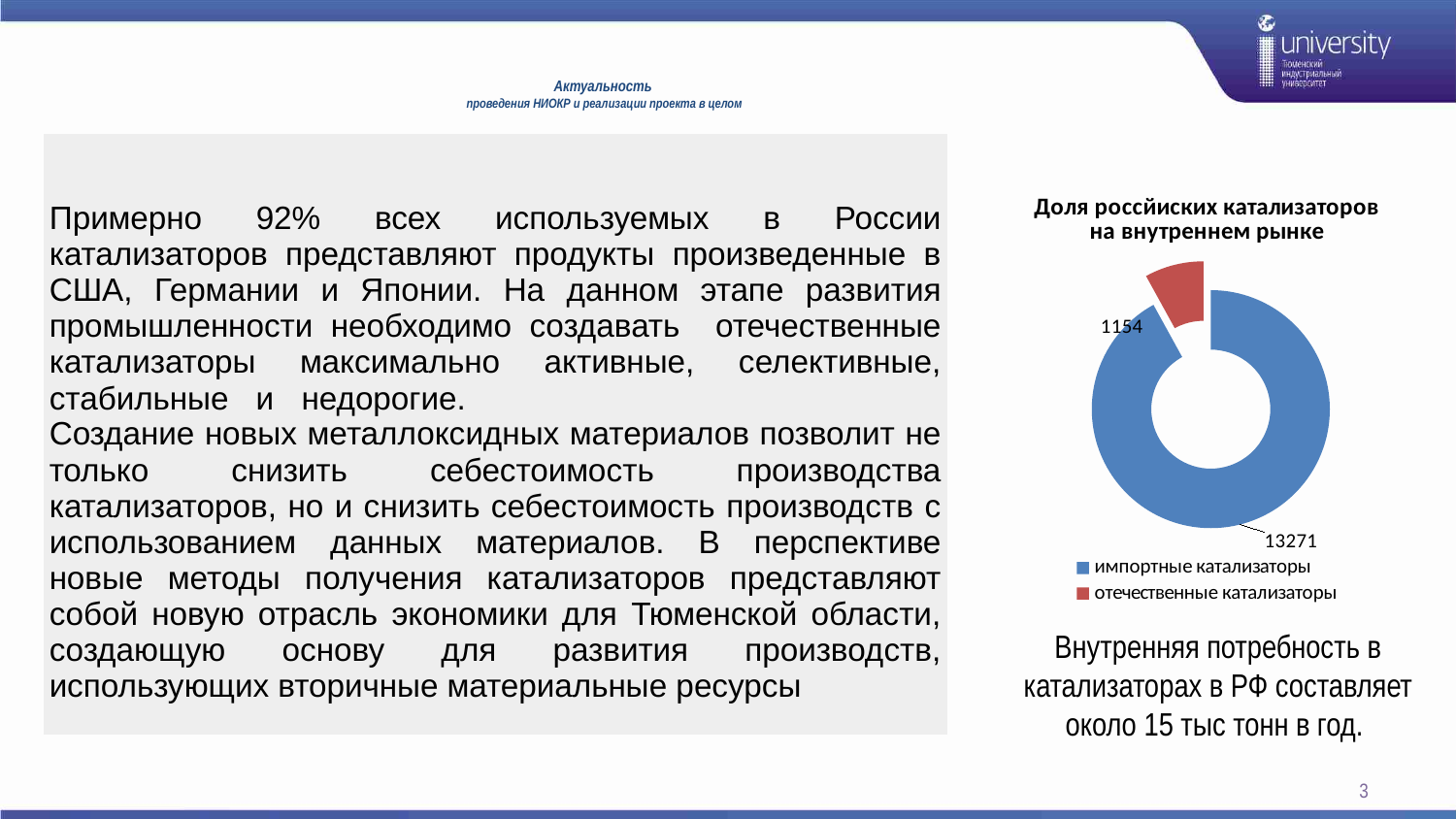
What kind of chart is shown on the slide? Doughnut (pie) chart What is the difference between the values for импортные катализаторы and отечественные катализаторы? 12117 What is the value for импортные катализаторы in the chart? 13271 Which is larger: the value for импортные катализаторы or for отечественные катализаторы? импортные катализаторы How many categories does the chart show? 2 What share of the total do отечественные катализаторы represent? 8% What colour represents импортные катализаторы in the chart? Blue How many entries does the chart legend list? 2 What is the title of the chart? Доля россйиских катализаторов на внутреннем рынке Which category has the largest value in the chart? импортные катализаторы Which category has the smallest value in the chart? отечественные катализаторы What is the value for отечественные катализаторы in the chart? 1154